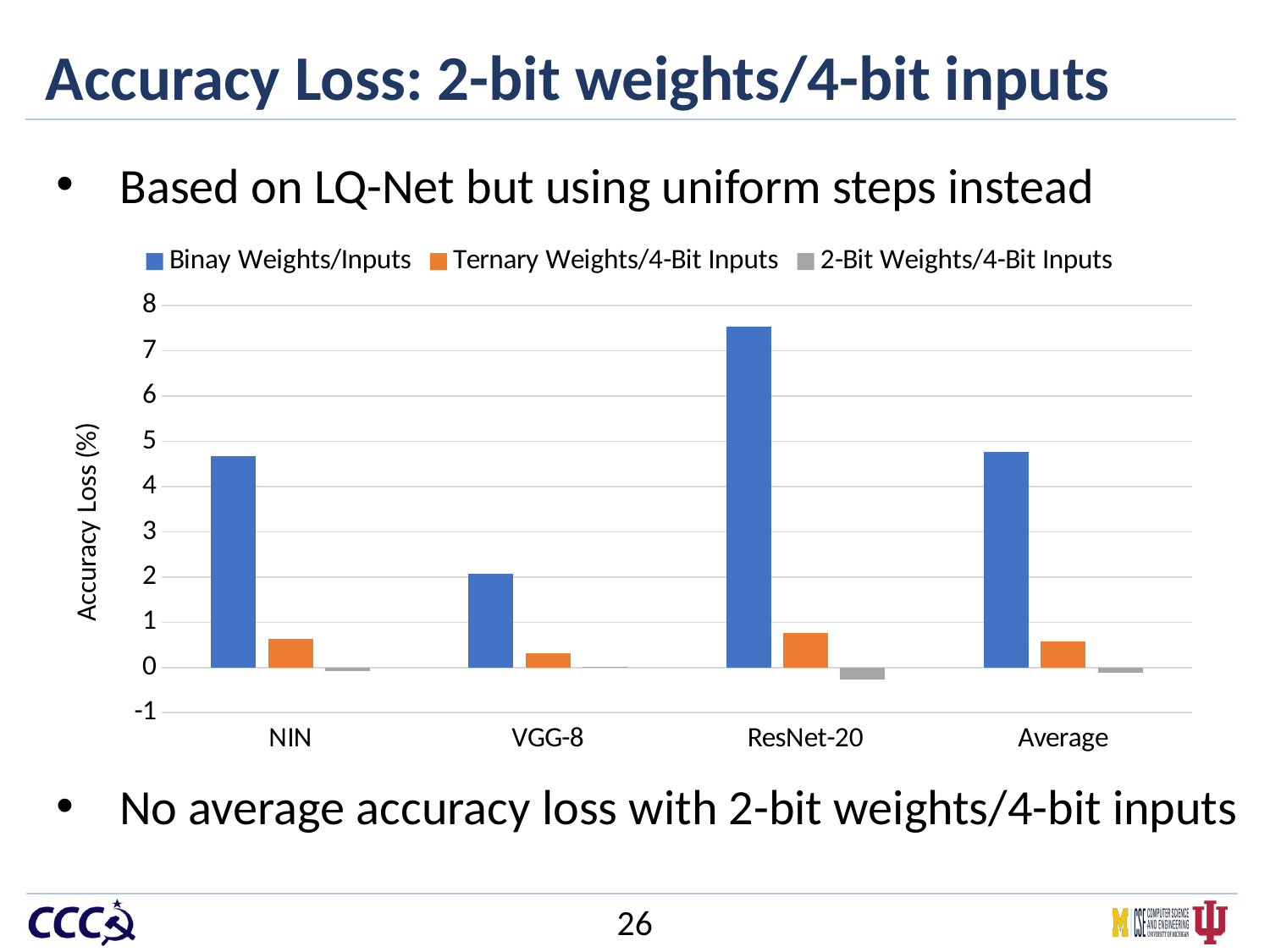
Which category has the highest value for Binay Weights/Inputs? ResNet-20 What kind of chart is shown on the slide? bar chart Is the value for Binay Weights/Inputs on ResNet-20 greater or less than 7? greater Which is larger for ResNet-20: the Binay Weights/Inputs value or the Ternary Weights/4-Bit Inputs value? Binay Weights/Inputs What is the label on the y axis of the chart? Accuracy Loss (%) Which category has the lowest value for Binay Weights/Inputs? VGG-8 Is the value for Binay Weights/Inputs on NIN greater or less than 4? greater Is the value for 2-Bit Weights/4-Bit Inputs on ResNet-20 greater or less than 0? less How many series does the legend list? 3 How many categories are shown on the x axis? 4